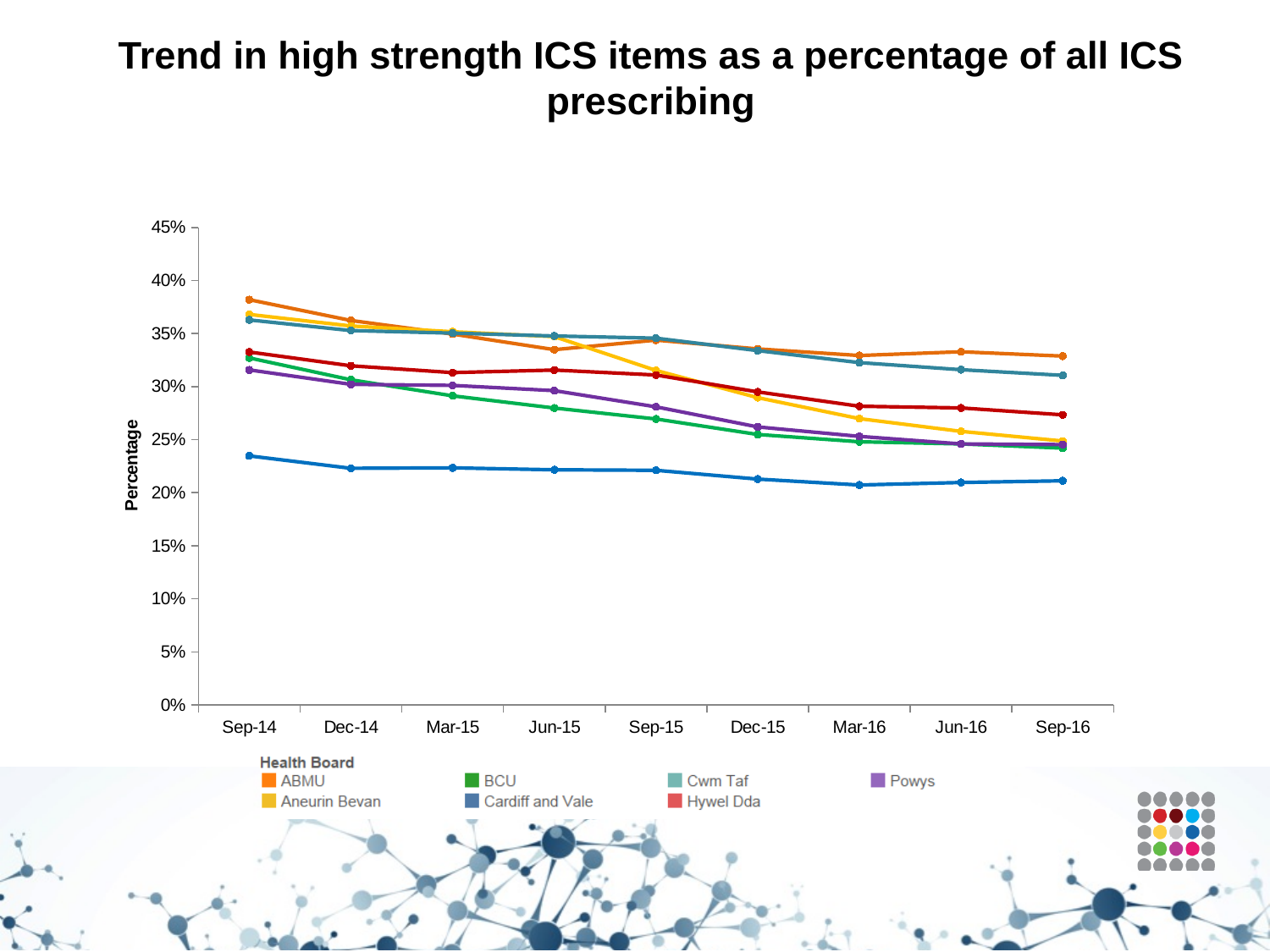
How many health boards does the legend list? 7 Is the value for Cardiff and Vale at Sep-14 greater or less than 25%? less What is the label on the y axis? Percentage Is the value for Hywel Dda at Sep-16 greater or less than 25%? greater Which health board has the lowest percentage at Sep-14? Cardiff and Vale Which health board has the highest percentage at Sep-14? ABMU What kind of chart is shown on the slide? line chart Which health board has the highest percentage at Sep-16? ABMU How many time points are shown along the x axis? 9 Is the value for ABMU at Sep-14 greater or less than 35%? greater Which is larger at Sep-16, the value for ABMU or the value for Cardiff and Vale? ABMU Does the Cardiff and Vale line generally rise or fall from Sep-14 to Sep-16? fall